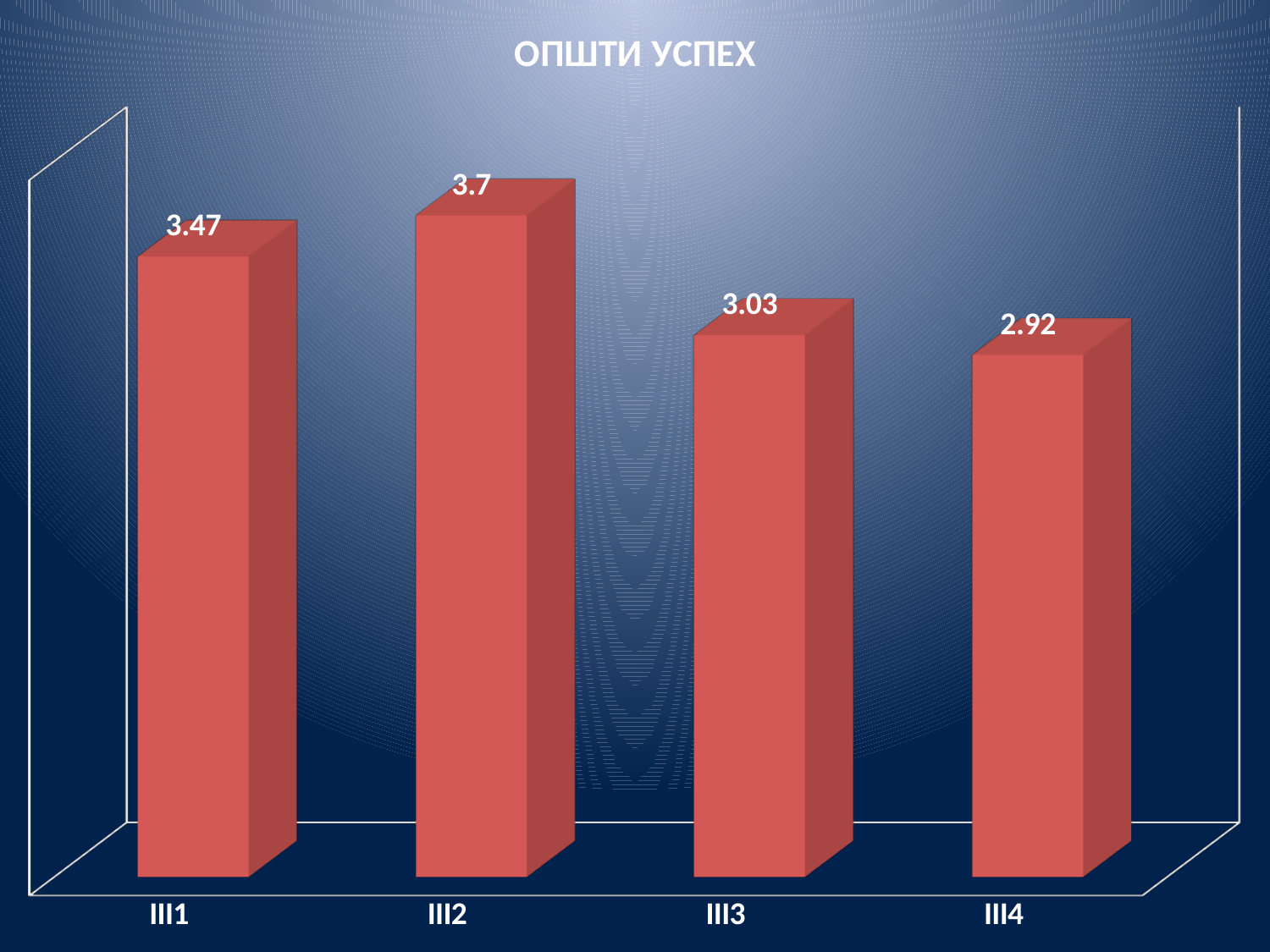
What is the difference between the values for III2 and III1? 0.23 Which category has the highest value? III2 Which category has the lowest value? III4 What is the title of the chart? ОПШТИ УСПЕХ What is the value for III1? 3.47 What kind of chart is shown on the slide? Bar chart Which is larger, the value for III1 or the value for III3? III1 What is the value for III2? 3.7 How many categories are shown in the chart? 4 What is the value for III3? 3.03 What is the value for III4? 2.92 What is the difference between the values for III3 and III4? 0.11